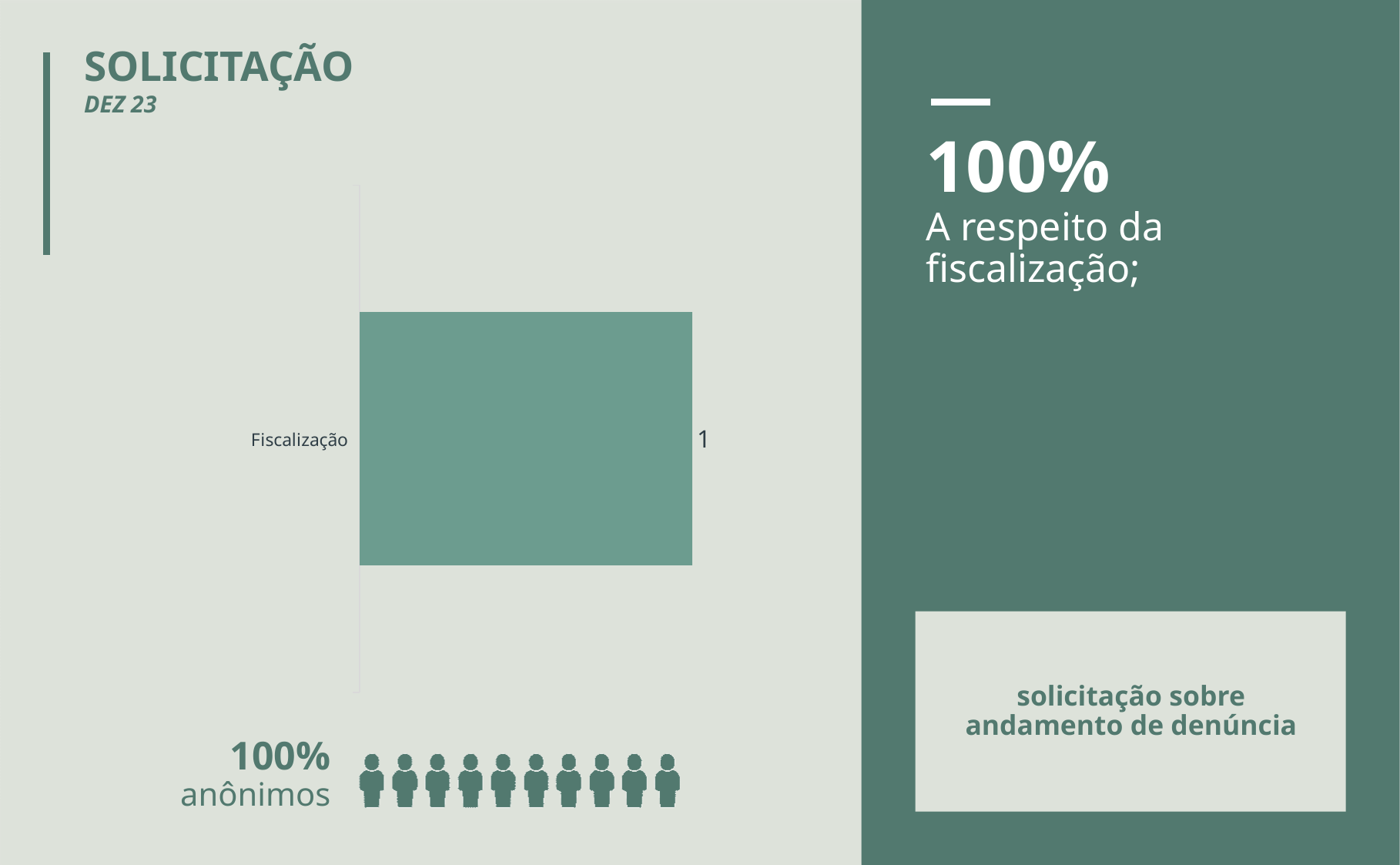
Which category has the highest value in the bar chart? Fiscalização Is the value for Fiscalização greater or less than 0? greater What is the label of the only category in the bar chart? Fiscalização Are the bars in the chart horizontal or vertical? horizontal What is the value for Fiscalização in the bar chart? 1 How many categories does the bar chart show? 1 What kind of chart is shown on the slide? bar chart